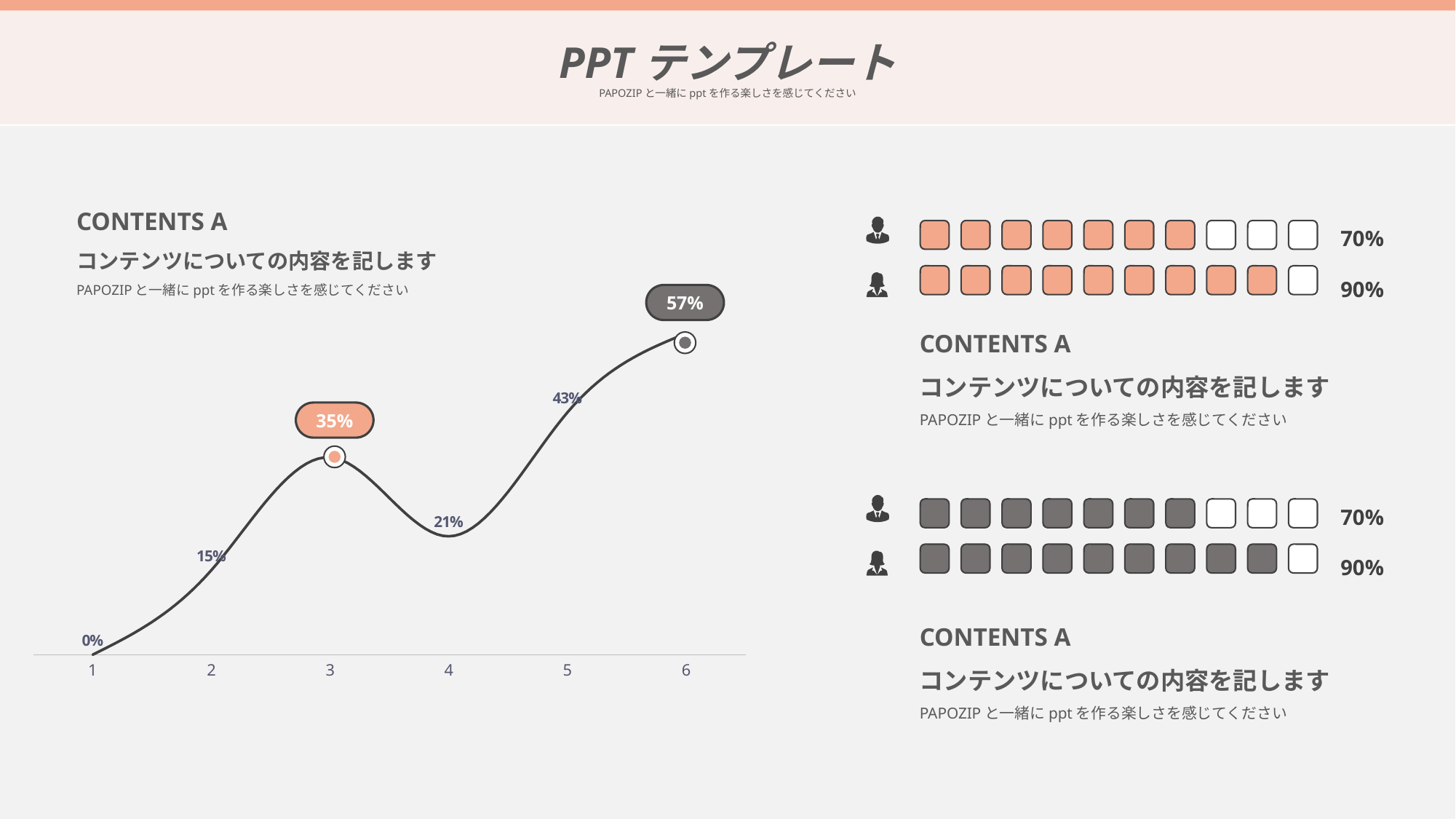
In the line chart, at which x value is the line lowest? 1 In the line chart, what is the value at x = 3? 35% In the line chart, what is the difference between the values at x = 3 and x = 2? 20% In the line chart, does the value rise or fall from x = 3 to x = 4? fall In the line chart, what is the value at x = 4? 21% In the line chart, what is the value at x = 2? 15% In the line chart, at which x value is the line highest? 6 How many data points are plotted in the line chart? 6 In the line chart, which has the larger value, x = 3 or x = 4? 3 What kind of chart is shown on the left of the slide? line chart In the line chart, what is the difference between the values at x = 6 and x = 5? 14% In the line chart, what is the value at x = 6? 57%